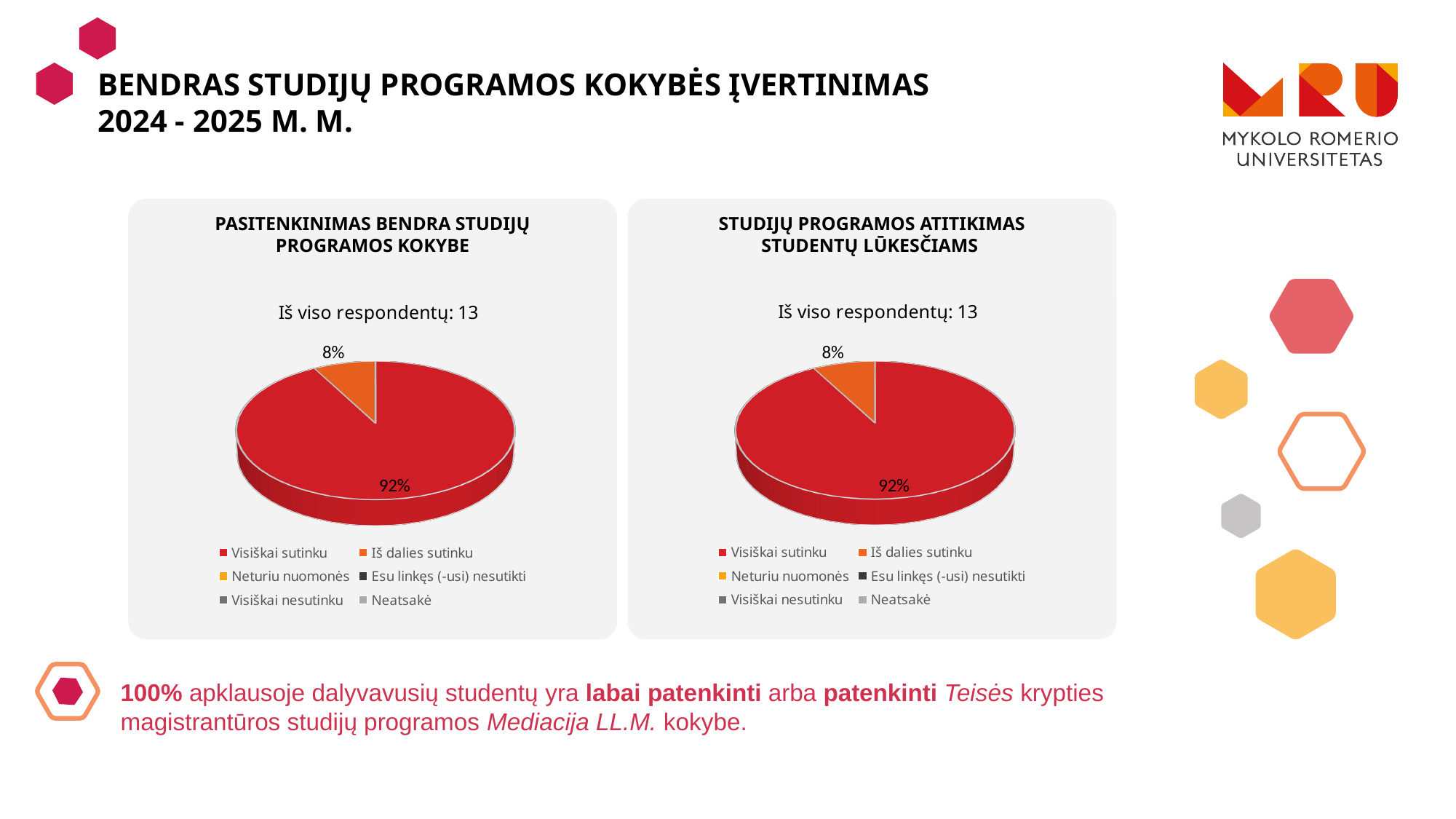
In the chart titled "Pasitenkinimas bendra studijų programos kokybe", what share of respondents answered "Visiškai sutinku"? 92% In the chart titled "Pasitenkinimas bendra studijų programos kokybe", what share of respondents answered "Iš dalies sutinku"? 8% How many response categories does the legend of the left chart list? 6 In the right chart, what colour is the slice representing "Iš dalies sutinku"? Orange In the chart titled "Studijų programos atitikimas studentų lūkesčiams", what share of respondents answered "Iš dalies sutinku"? 8% In the left chart, which response category has the largest slice? Visiškai sutinku In the left chart, what is the difference in percentage points between the "Visiškai sutinku" and "Iš dalies sutinku" slices? 84 percentage points In the right chart, which of the two labelled slices is the smaller one? Iš dalies sutinku In the chart titled "Studijų programos atitikimas studentų lūkesčiams", what share of respondents answered "Visiškai sutinku"? 92% What type of chart is used in the "Studijų programos atitikimas studentų lūkesčiams" panel? Pie chart How many respondents in total are reported for the chart titled "Pasitenkinimas bendra studijų programos kokybe"? 13 In the right chart, which slice is larger: "Visiškai sutinku" or "Iš dalies sutinku"? Visiškai sutinku